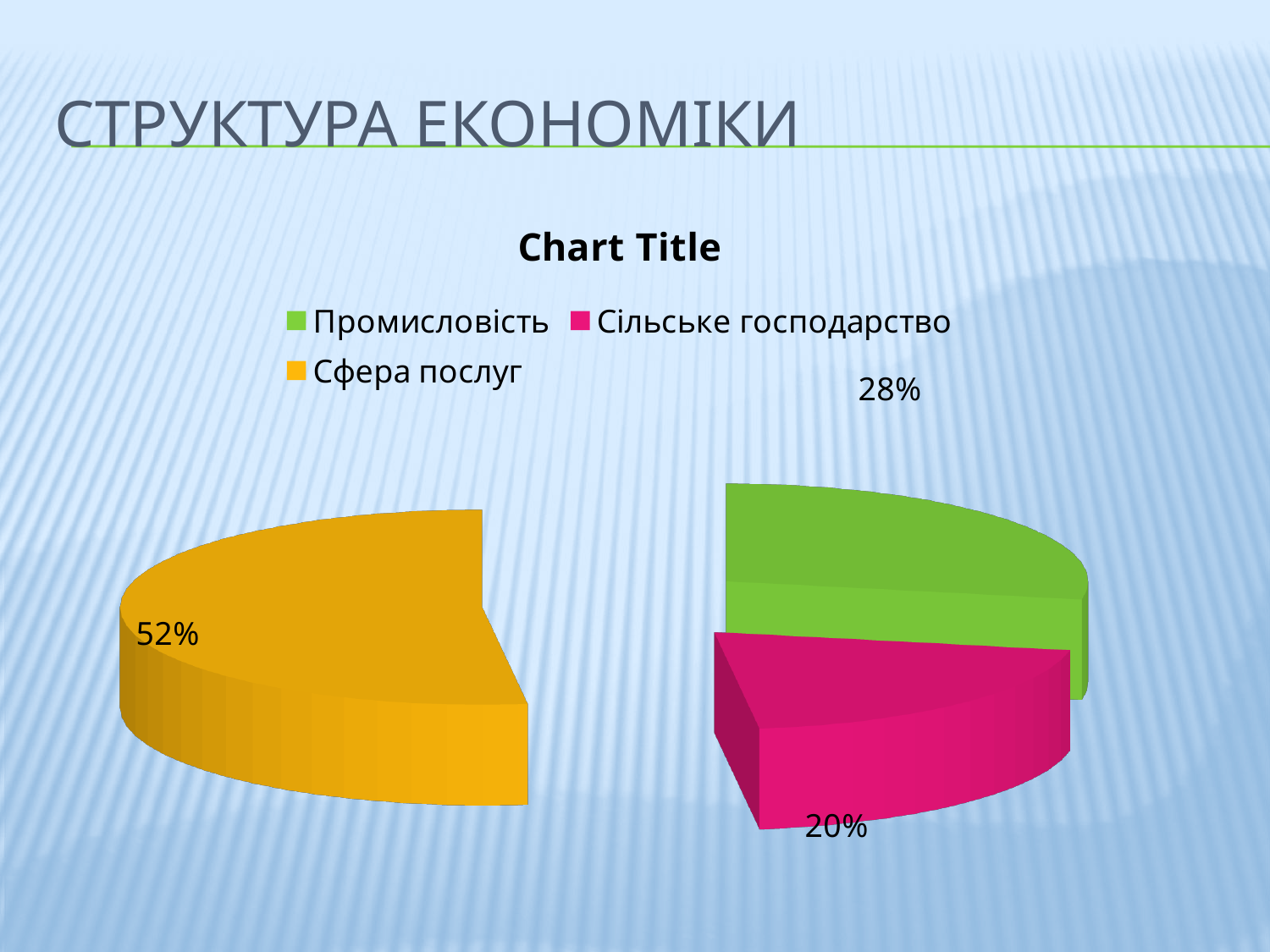
What share of the pie does Сфера послуг have? 52% What colour is the slice for Сфера послуг? yellow What share of the pie does Сільське господарство have? 20% How many slices does the pie chart have? 3 What type of chart is shown on the slide? pie chart What is the title shown above the chart? Chart Title What is the difference in percentage points between Промисловість and Сільське господарство? 8 Which category has the smallest slice of the pie? Сільське господарство Which is larger, the slice for Промисловість or the slice for Сільське господарство? Промисловість What is the difference in percentage points between Сфера послуг and Промисловість? 24 What share of the pie does Промисловість have? 28% Which category has the largest slice of the pie? Сфера послуг